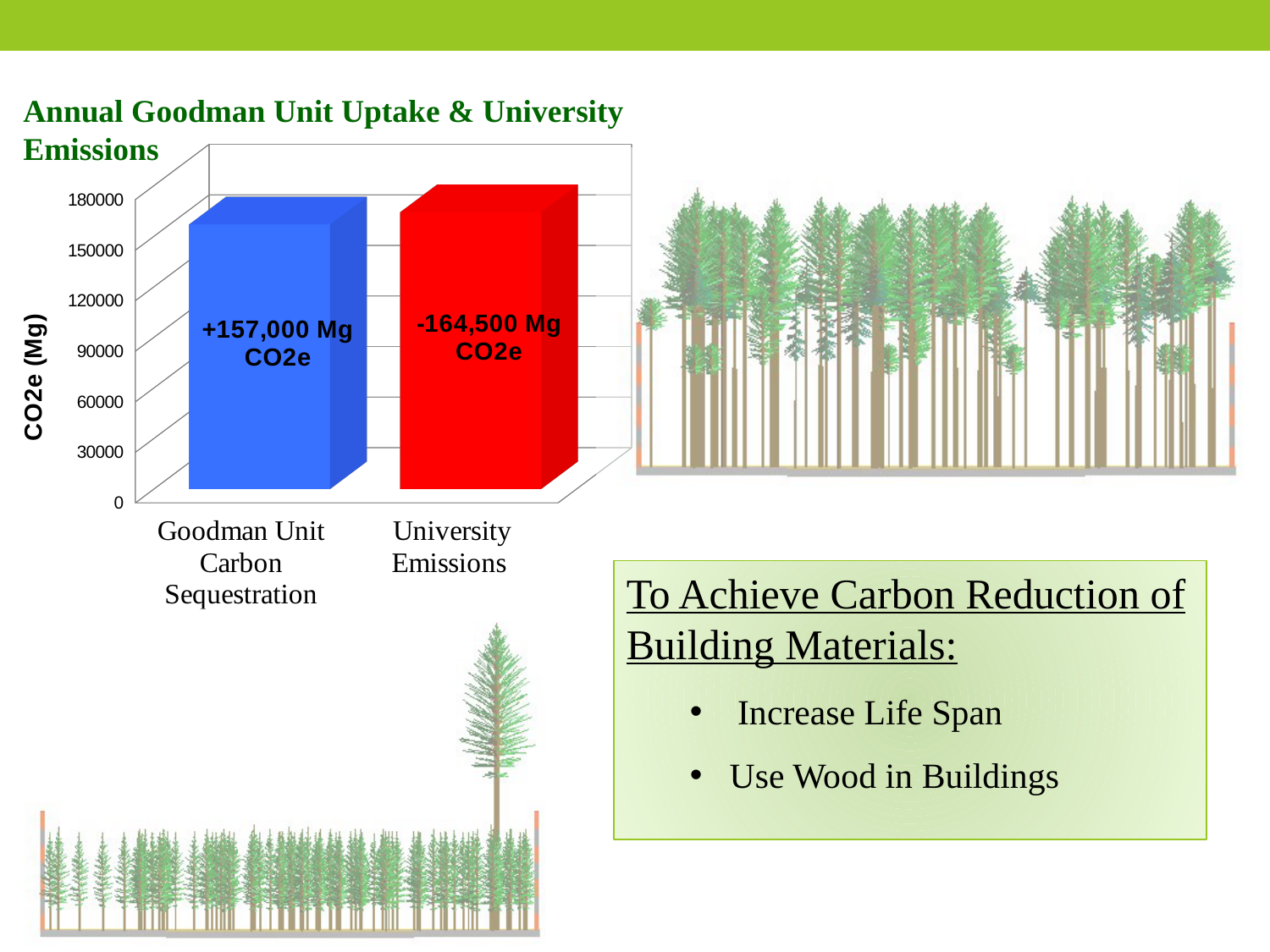
Is the value for Goodman Unit Carbon Sequestration greater or less than 150000? greater Is the bar for Goodman Unit Carbon Sequestration taller or shorter than the bar for University Emissions? shorter How many categories are shown in the chart? 2 What is the label on the vertical axis of the chart? CO2e (Mg) What value is labelled on the University Emissions bar? -164,500 Mg CO2e Is the value for University Emissions greater or less than 120000? greater What kind of chart is shown on the slide? bar chart Which category has the shorter bar? Goodman Unit Carbon Sequestration What is the title of the chart? Annual Goodman Unit Uptake & University Emissions Which category has the taller bar? University Emissions What value is labelled on the Goodman Unit Carbon Sequestration bar? +157,000 Mg CO2e By how many Mg CO2e does the magnitude of University Emissions exceed the Goodman Unit Carbon Sequestration? 7,500 Mg CO2e